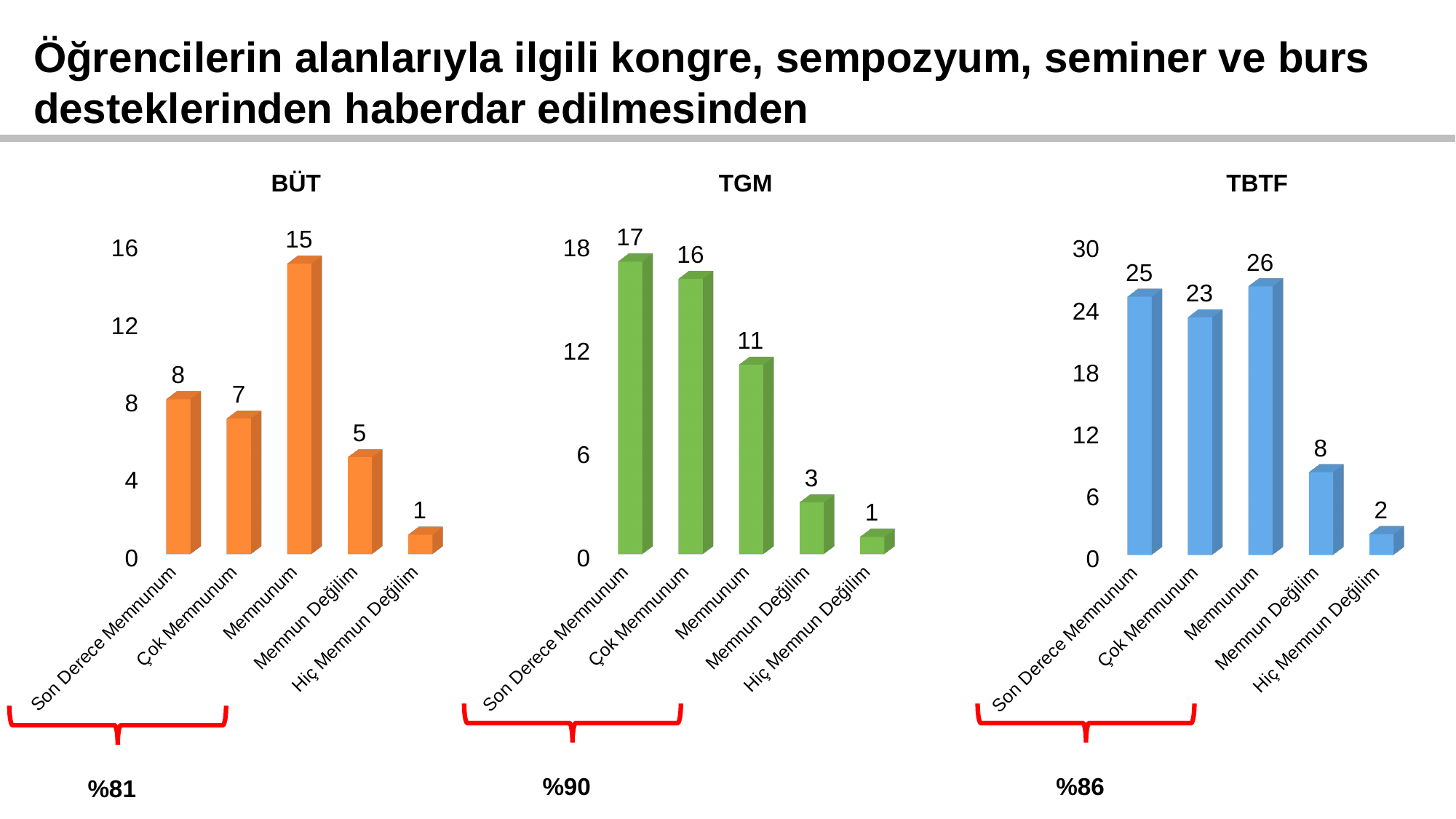
In the TBTF chart, which category has the highest value? Memnunum In the BÜT chart, what is the value for Memnunum? 15 In the TBTF chart, what is the difference between Memnunum and Çok Memnunum? 3 What percentage is shown below the bracket under the TGM chart? %90 In the TBTF chart, what is the value for Memnun Değilim? 8 How many categories does the TGM chart show? 5 In the BÜT chart, what is the difference between Son Derece Memnunum and Hiç Memnun Değilim? 7 In the TGM chart, which category has the lowest value? Hiç Memnun Değilim In the TGM chart, which is larger: Çok Memnunum or Memnunum? Çok Memnunum What type of chart is the TBTF chart? Bar chart In the TGM chart, what is the value for Son Derece Memnunum? 17 In the BÜT chart, which category has the highest value? Memnunum